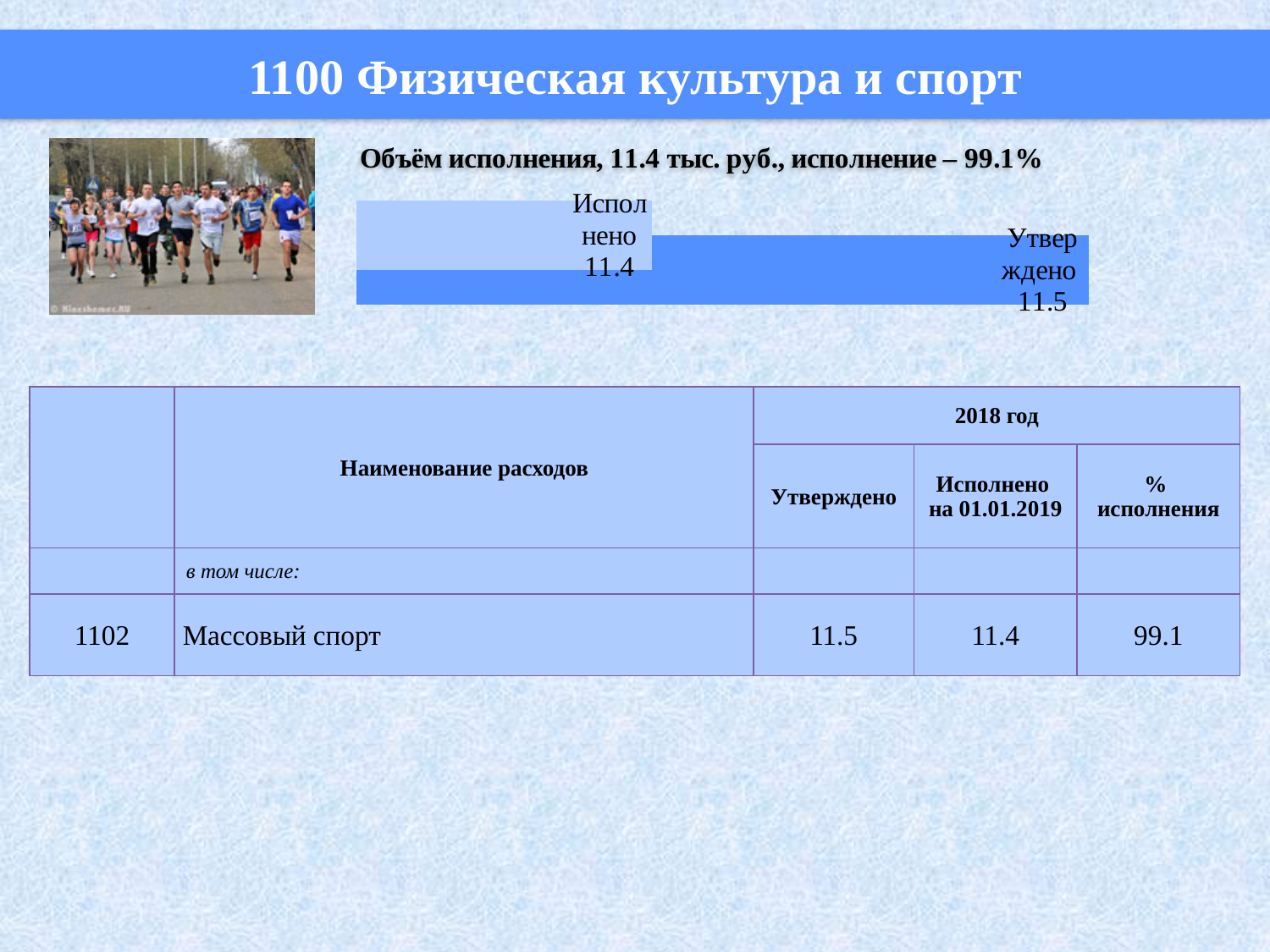
How many bars are plotted in the chart? 2 Which bar in the chart has the higher value? Утверждено What is the difference between the Утверждено and Исполнено values in the chart? 0.1 What kind of chart is shown on the slide? bar chart What is the value of the Исполнено bar in the chart? 11.4 What is the value of the Утверждено bar in the chart? 11.5 Which bar in the chart is drawn in the lighter blue colour? Исполнено Which bar in the chart has the lower value? Исполнено Is the Исполнено value larger or smaller than the Утверждено value in the chart? smaller Which bar in the chart is drawn in the darker blue colour? Утверждено